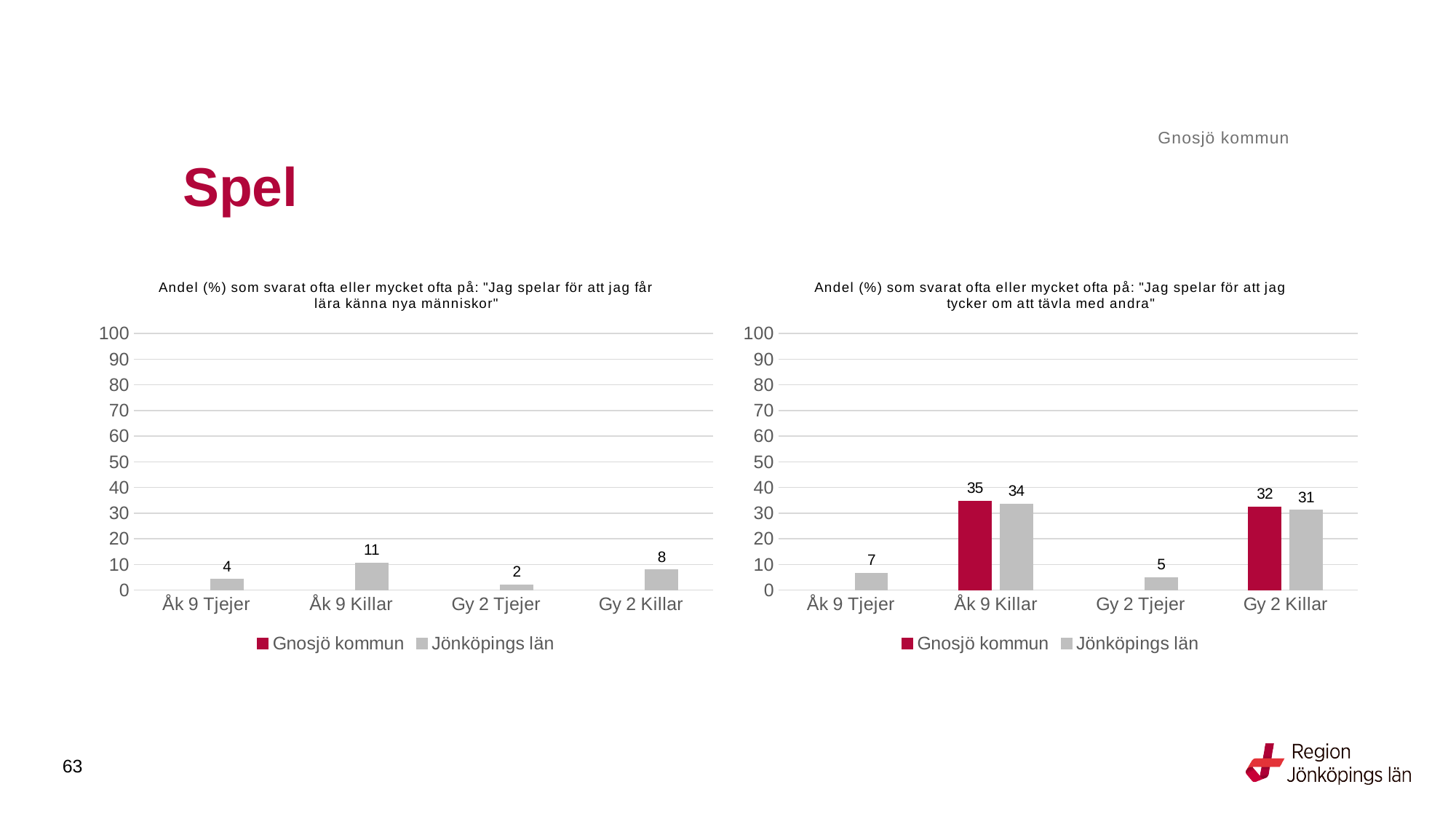
In the right chart, what is the value for Gnosjö kommun for Åk 9 Killar? 35 In the right chart, which is larger for Gy 2 Killar: Gnosjö kommun or Jönköpings län? Gnosjö kommun In the left chart, what is the difference between the Jönköpings län values for Åk 9 Killar and Gy 2 Killar? 3 How many series does the legend of the left chart list? 2 In the left chart, what is the value for Jönköpings län for Åk 9 Killar? 11 In the left chart, which category has the lowest value for Jönköpings län? Gy 2 Tjejer How many categories are shown on the x axis of the right chart? 4 In the right chart, is the value for Jönköpings län for Åk 9 Tjejer greater or less than 10? less In the left chart, which category has the highest value for Jönköpings län? Åk 9 Killar In the right chart, what is the difference between the Jönköpings län values for Åk 9 Killar and Åk 9 Tjejer? 27 In the right chart, what is the value for Jönköpings län for Gy 2 Killar? 31 In the left chart, what is the value for Jönköpings län for Gy 2 Tjejer? 2